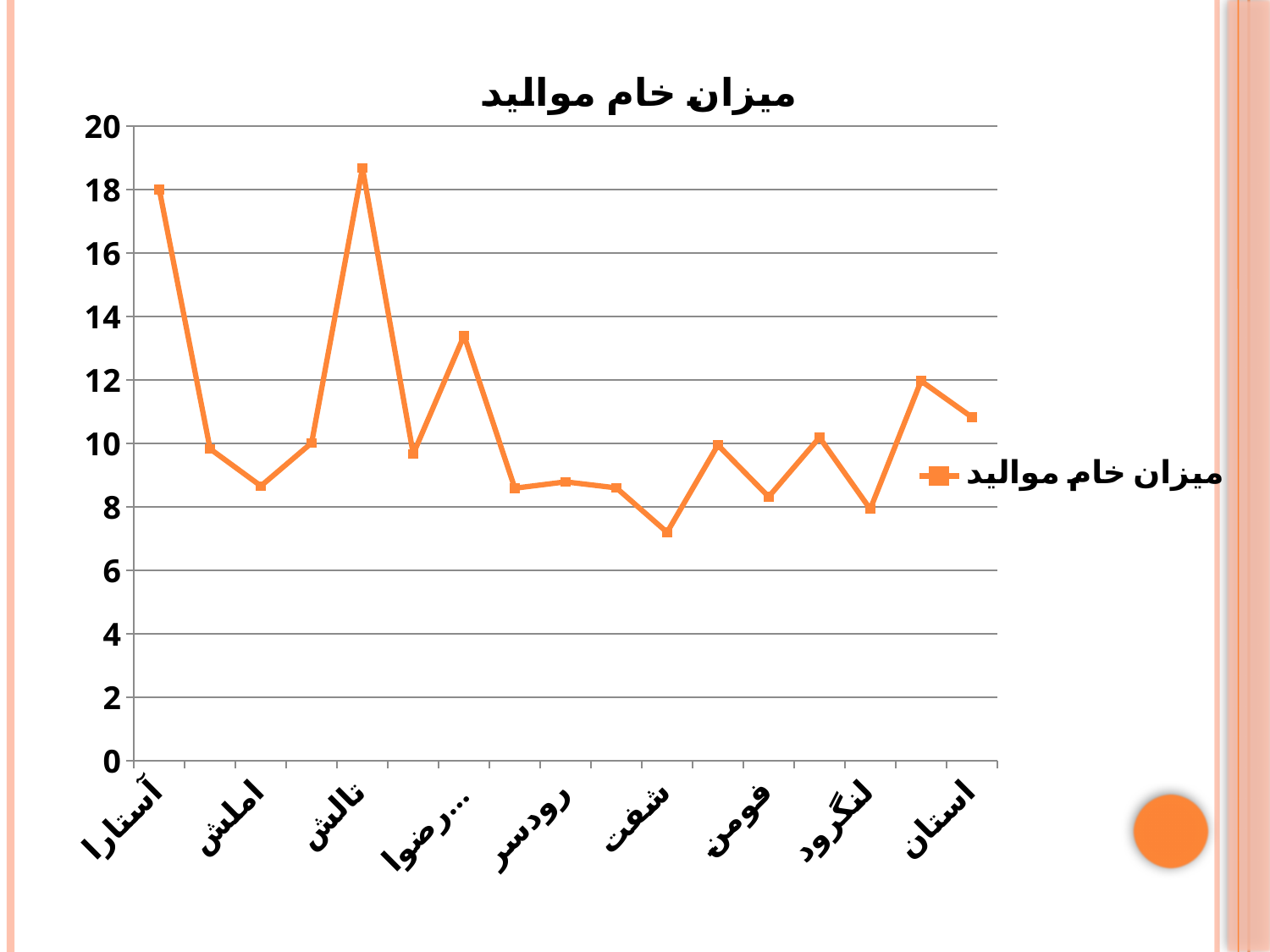
Which has the larger value, استان or شفت? استان Is the value for آستارا greater or less than 16? greater Is the value for شفت greater or less than 8? less Which labelled category has the lowest value? شفت Is the value for فومن greater or less than 10? less How many data points are plotted on the line? 17 Which labelled category has the highest value? تالش What kind of chart is shown on the slide? line chart How many series does the legend list? 1 What is the title of the chart? میزان خام موالید Which has the larger value, آستارا or املش? آستارا